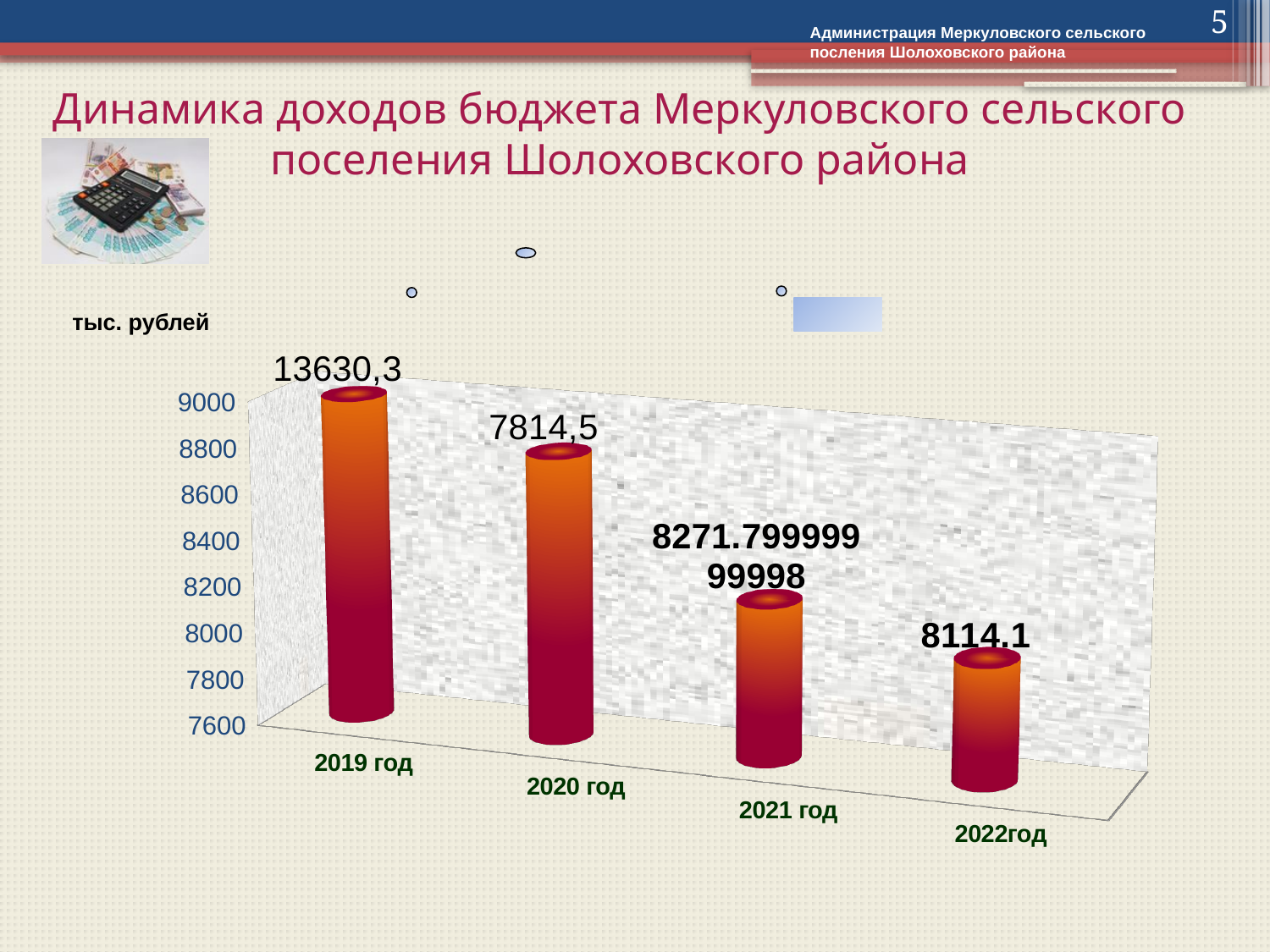
What value is labelled for 2022год? 8114.1 Which is larger, the value for 2019 год or for 2020 год? 2019 год What is the lowest tick value shown on the vertical axis? 7600 How many years are shown on the chart? 4 Which year has the highest value on the chart? 2019 год What kind of chart is shown on the slide? bar chart Which is larger, the value for 2021 год or for 2022год? 2021 год What value is labelled for 2019 год? 13630,3 What is the difference between the labelled values for 2019 год and 2020 год? 5815,8 Do the bars get taller or shorter from 2019 год to 2022год? shorter What value is labelled for 2020 год? 7814,5 What unit is written above the vertical axis of the chart? тыс. рублей